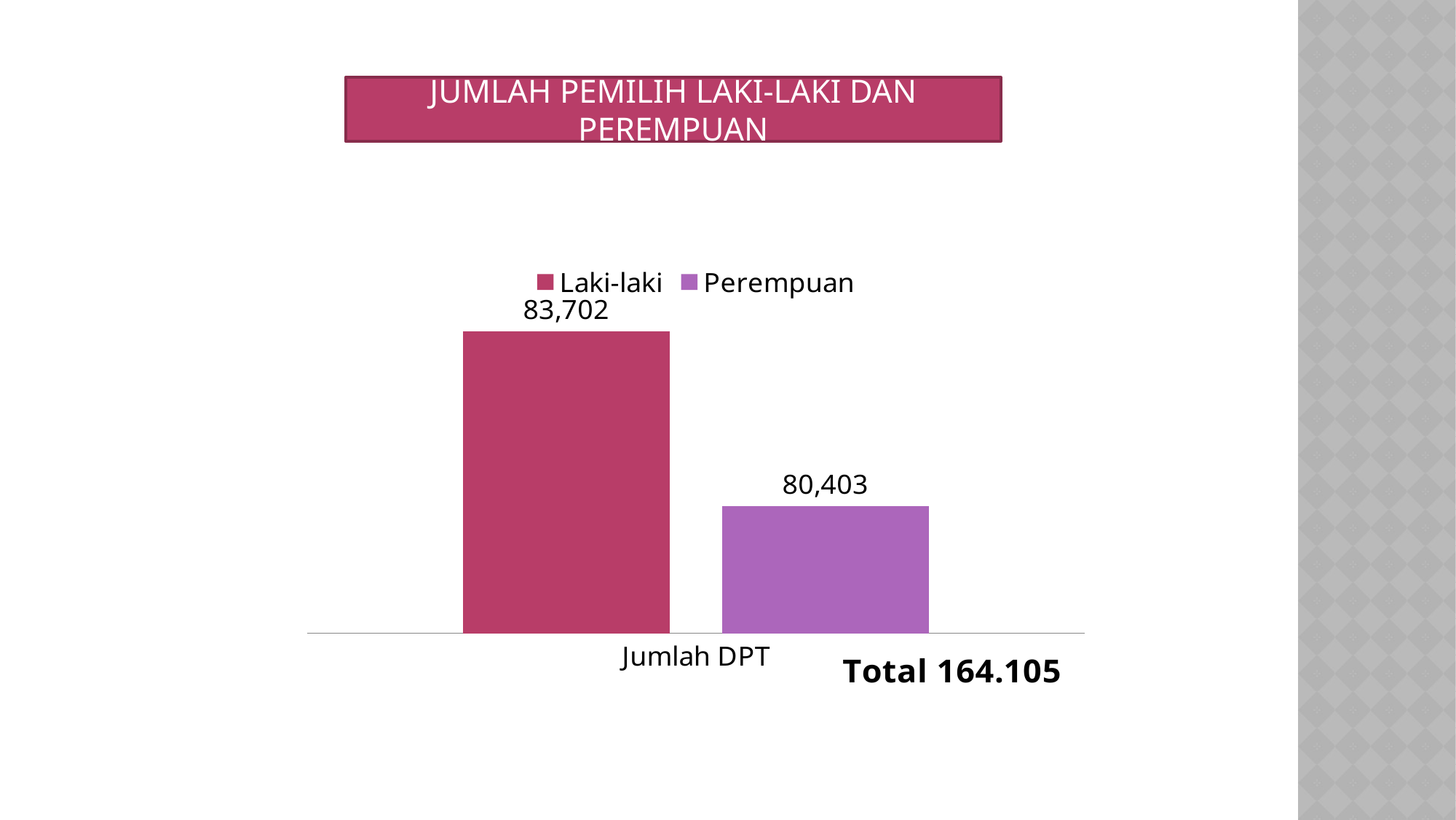
What total is printed below the chart? Total 164.105 What is the value for Laki-laki in the chart? 83,702 How many bars are plotted in the chart? 2 What is the title of the chart? JUMLAH PEMILIH LAKI-LAKI DAN PEREMPUAN What is the difference between the Laki-laki and Perempuan values? 3,299 What is the value for Perempuan in the chart? 80,403 Which series has the highest value in the chart? Laki-laki Which series has the lowest value in the chart? Perempuan What is the category label shown on the x axis? Jumlah DPT Which series has the higher value, Laki-laki or Perempuan? Laki-laki What kind of chart is shown on the slide? Bar chart How many series does the legend list? 2